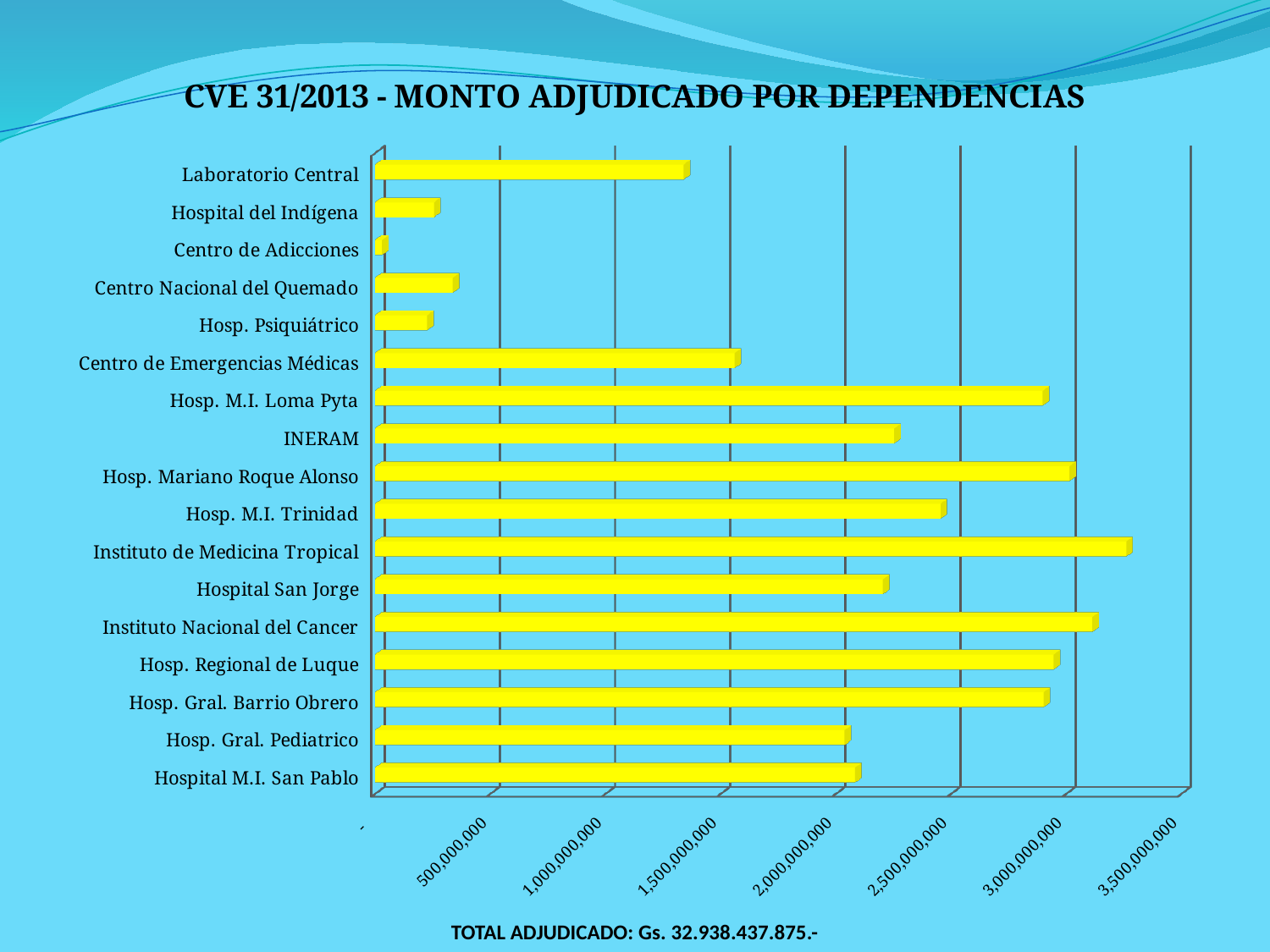
Which has a larger adjudicated amount, Hosp. M.I. Loma Pyta or INERAM? Hosp. M.I. Loma Pyta Is the value for INERAM greater or less than 2,000,000,000? greater Is the value for Hospital del Indígena greater or less than 500,000,000? less Is the value for Centro de Emergencias Médicas greater or less than 1,500,000,000? greater What kind of chart is shown on the slide? Bar chart What is the title of the chart? CVE 31/2013 - MONTO ADJUDICADO POR DEPENDENCIAS Which dependency has the lowest adjudicated amount? Centro de Adicciones Which has a larger adjudicated amount, Hospital San Jorge or Hosp. M.I. Trinidad? Hosp. M.I. Trinidad How many dependencies (categories) are plotted in the chart? 17 Which dependency has the highest adjudicated amount? Instituto de Medicina Tropical